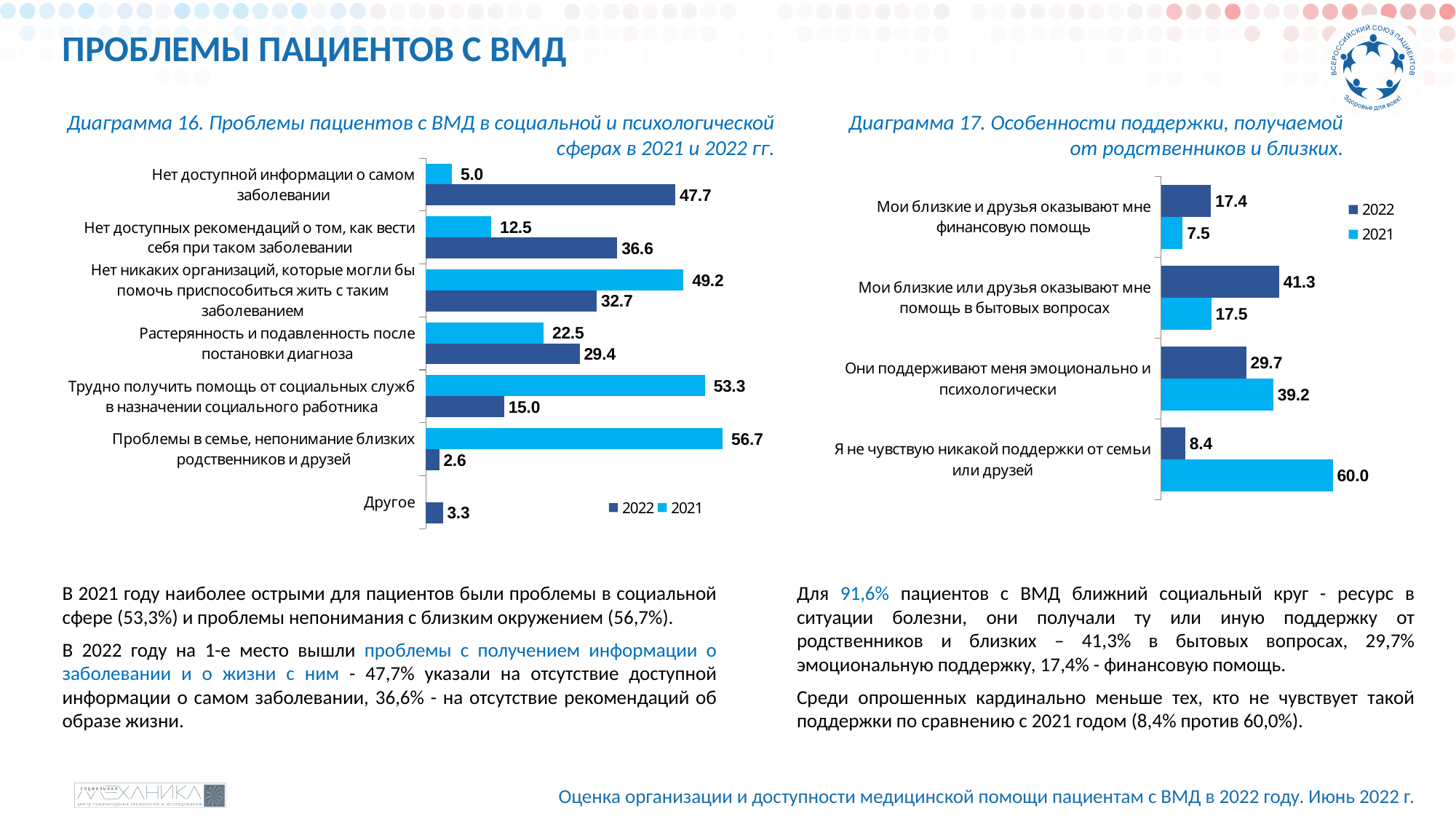
In Diagram 16 (left chart), what is the difference between the 2021 and 2022 values for "Трудно получить помощь от социальных служб в назначении социального работника"? 38.3 In Diagram 16 (left chart), which category has the lowest 2022 value? Проблемы в семье, непонимание близких родственников и друзей What type of chart is Diagram 16 (left chart)? Bar chart In Diagram 17 (right chart), what is the 2022 value for "Мои близкие или друзья оказывают мне помощь в бытовых вопросах"? 41.3 In Diagram 16 (left chart), which category has the highest 2021 value? Проблемы в семье, непонимание близких родственников и друзей In Diagram 16 (left chart), what is the 2021 value for "Проблемы в семье, непонимание близких родственников и друзей"? 56.7 How many series does the legend of Diagram 17 (right chart) list? 2 In Diagram 17 (right chart), which is larger for "Они поддерживают меня эмоционально и психологически": the 2022 value or the 2021 value? 2021 In Diagram 17 (right chart), what is the difference between the 2022 and 2021 values for "Мои близкие и друзья оказывают мне финансовую помощь"? 9.9 In Diagram 17 (right chart), what is the 2021 value for "Я не чувствую никакой поддержки от семьи или друзей"? 60.0 In Diagram 16 (left chart), how many categories are shown? 7 In Diagram 16 (left chart), what is the 2022 value for "Нет доступной информации о самом заболевании"? 47.7